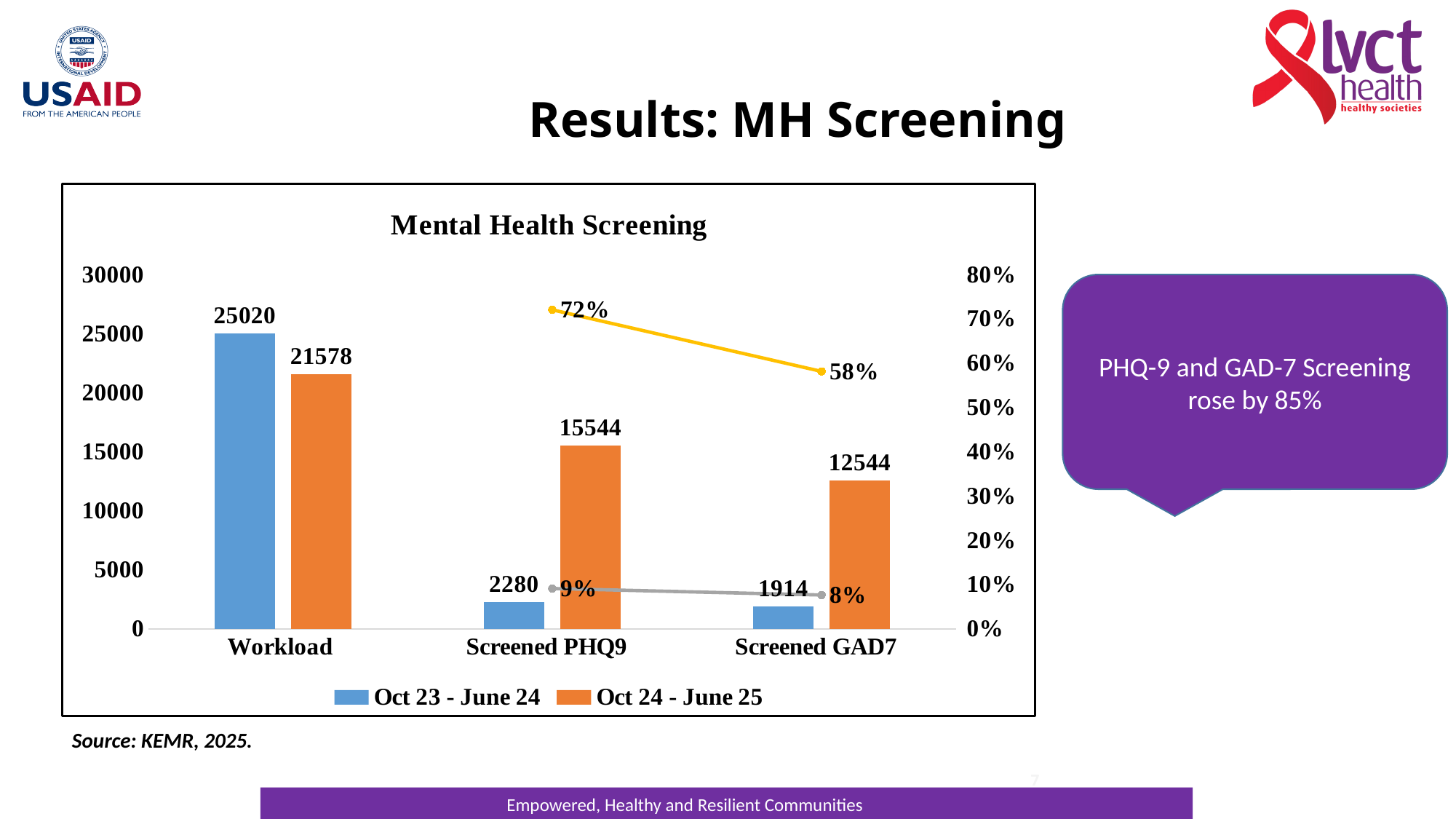
What is the Screened GAD7 value for Oct 23 - June 24? 1914 What is the Screened PHQ9 value for Oct 24 - June 25? 15544 What is the Workload value for Oct 23 - June 24? 25020 What is the Workload value for Oct 24 - June 25? 21578 Which category has the lowest value for Oct 23 - June 24? Screened GAD7 How many categories are shown on the x axis? 3 What percentage is labelled on the yellow line at Screened GAD7? 58% Which is larger: the Workload value for Oct 23 - June 24 or for Oct 24 - June 25? Oct 23 - June 24 Which category has the highest value for Oct 24 - June 25? Workload What is the difference between the Screened PHQ9 values for Oct 24 - June 25 and Oct 23 - June 24? 13264 How many series does the legend list? 2 What is the title of the chart? Mental Health Screening